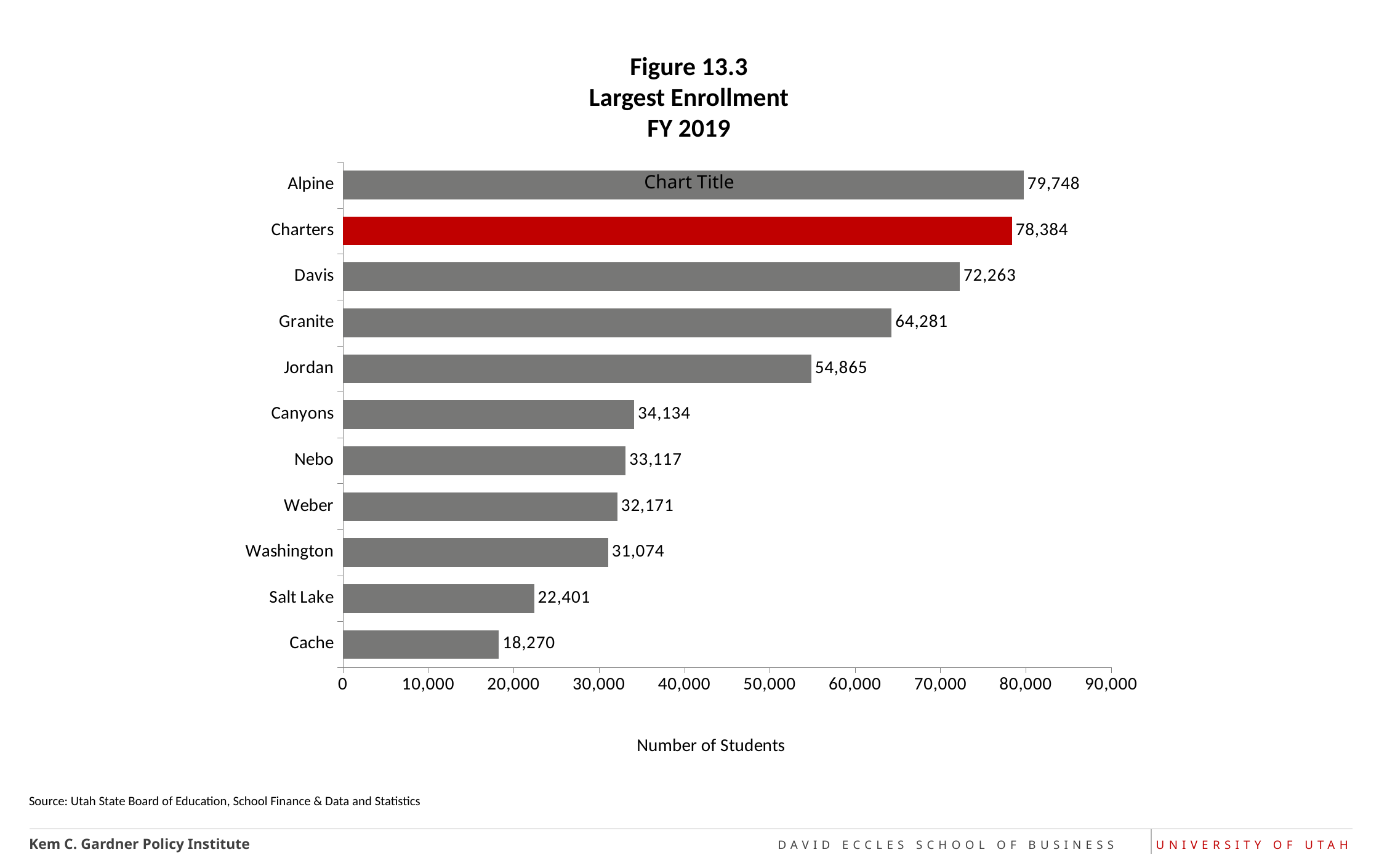
How many categories are shown in the chart? 11 What is the difference in number of students between Granite and Jordan? 9,416 Which category has the smallest enrollment? Cache Which bar is highlighted in red? Charters Which has more students, Canyons or Weber? Canyons What is the number of students for Davis? 72,263 What is the number of students for Salt Lake? 22,401 Is the value for Washington greater or less than 40,000? less What is the difference in number of students between Alpine and Charters? 1,364 Which category has the largest enrollment? Alpine What is the number of students for Charters? 78,384 What kind of chart is shown on the slide? bar chart